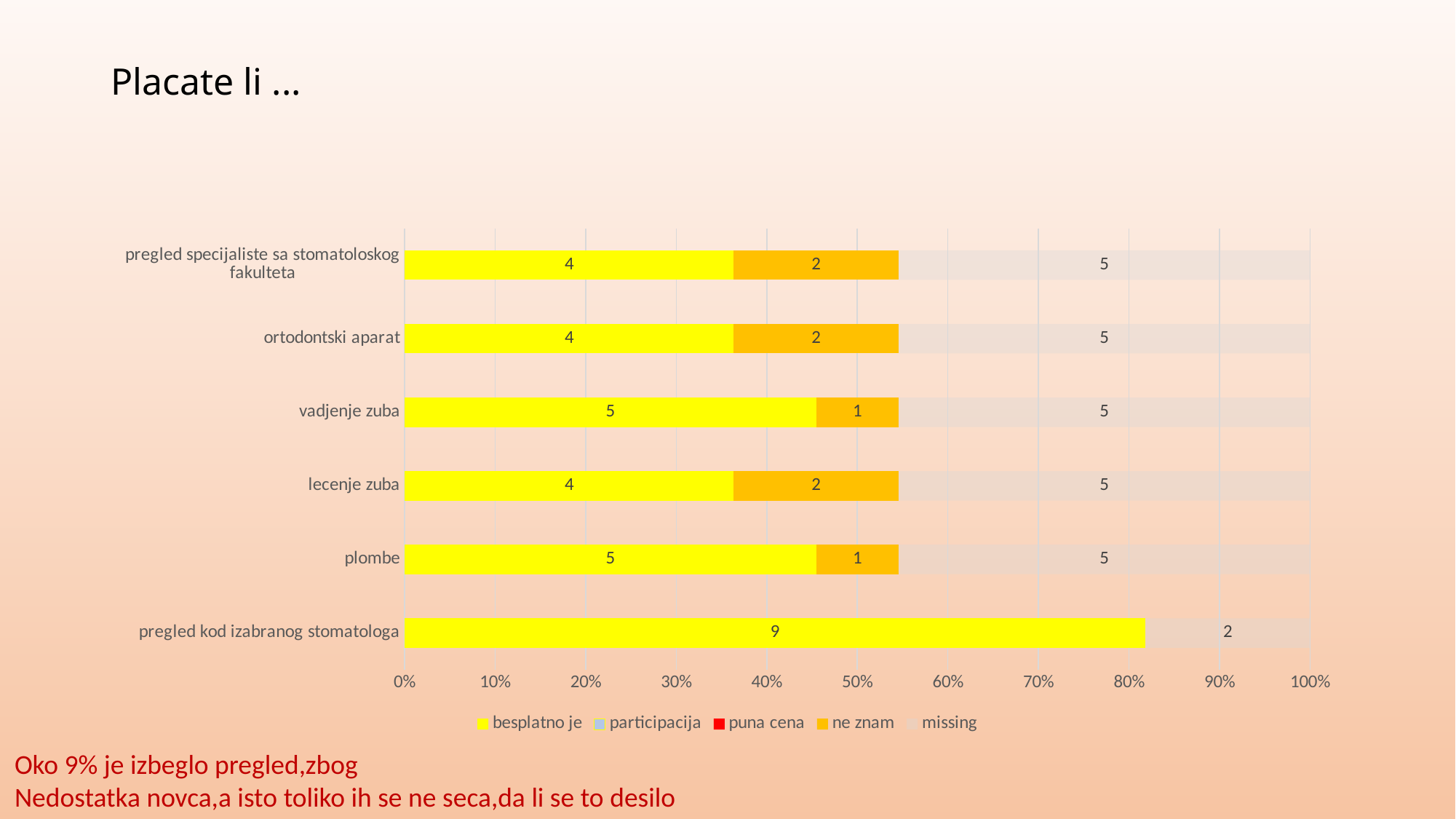
Is the share of the "besplatno je" segment for "pregled kod izabranog stomatologa" greater or less than 70%? greater Which category has the highest "besplatno je" value? pregled kod izabranog stomatologa What is the total of the labelled segments in the bar for "pregled kod izabranog stomatologa"? 11 What is the difference between the "besplatno je" value for "pregled kod izabranog stomatologa" and the "besplatno je" value for "plombe"? 4 What kind of chart is shown on the slide? stacked bar chart How many categories are shown on the y axis of the chart? 6 How many series does the legend list? 5 Which has the larger "ne znam" value, "lecenje zuba" or "vadjenje zuba"? lecenje zuba What is the value of the "missing" segment for "plombe"? 5 What is the value of the "besplatno je" segment for "pregled kod izabranog stomatologa"? 9 What is the value of the "ne znam" segment for "vadjenje zuba"? 1 What is the title of the slide? Placate li ...